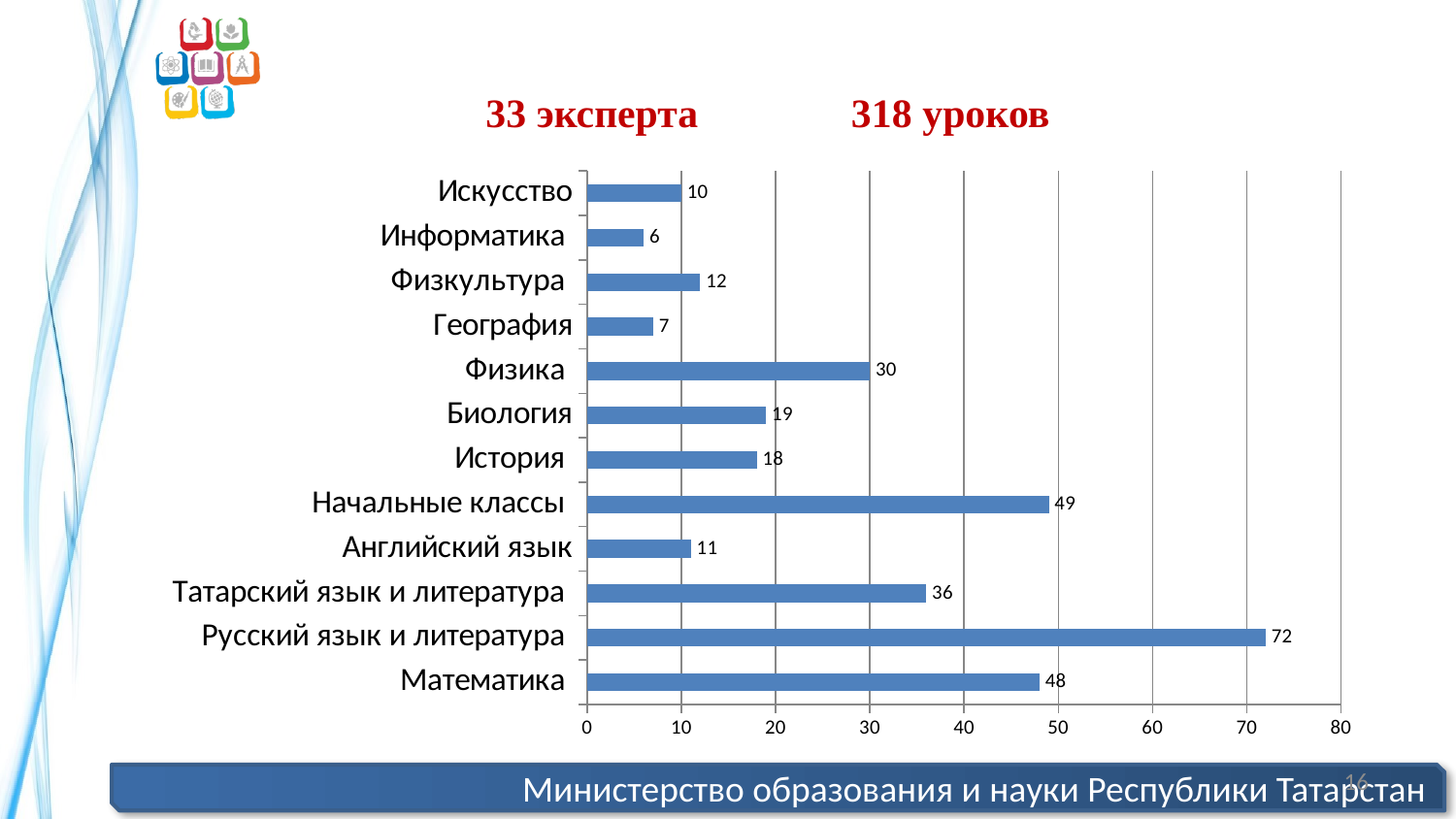
What is the difference between the values for Русский язык и литература and Математика? 24 Which category has the highest value? Русский язык и литература Which is larger, the value for Физика or the value for Биология? Физика Which category has the lowest value? Информатика What is the value for Начальные классы? 49 What is the maximum value shown on the horizontal axis? 80 What is the value for Русский язык и литература? 72 How many categories are shown in the chart? 12 What kind of chart is shown on the slide? bar chart Is the value for Татарский язык и литература greater or less than 30? greater What is the value for Информатика? 6 What is the difference between the values for Начальные классы and Математика? 1